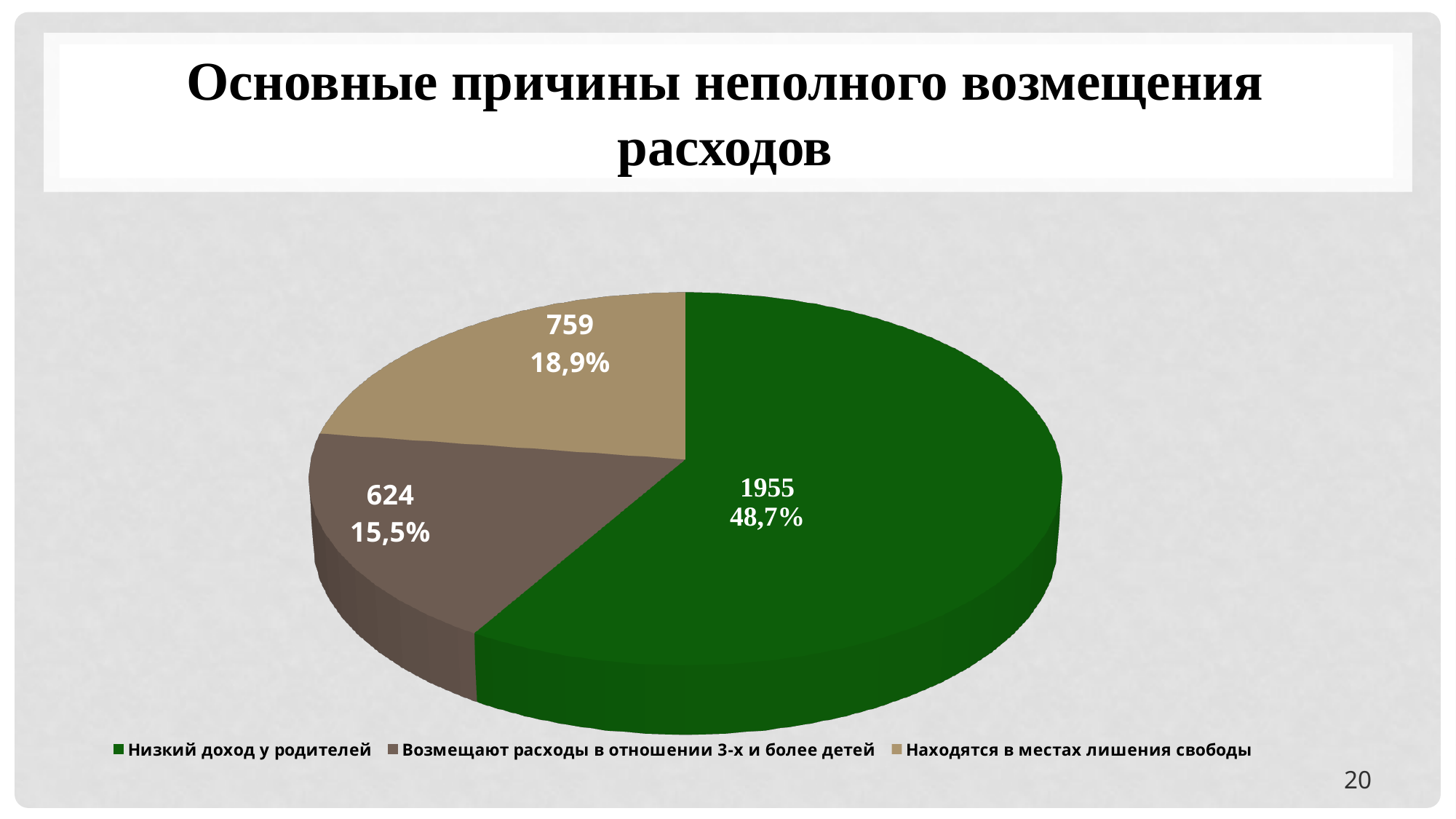
Which is larger: the value for "Находятся в местах лишения свободы" or for "Возмещают расходы в отношении 3-х и более детей"? Находятся в местах лишения свободы What percentage share is shown for the "Низкий доход у родителей" slice? 48,7% How many slices does the pie chart have? 3 What kind of chart is shown on the slide? pie chart What is the difference between the values for "Низкий доход у родителей" and "Находятся в местах лишения свободы"? 1196 What colour is the slice for "Низкий доход у родителей"? green Which category has the smallest slice? Возмещают расходы в отношении 3-х и более детей What percentage share is shown for the "Находятся в местах лишения свободы" slice? 18,9% What is the value for "Низкий доход у родителей"? 1955 What is the value for "Находятся в местах лишения свободы"? 759 Which category has the largest slice? Низкий доход у родителей What is the value for "Возмещают расходы в отношении 3-х и более детей"? 624